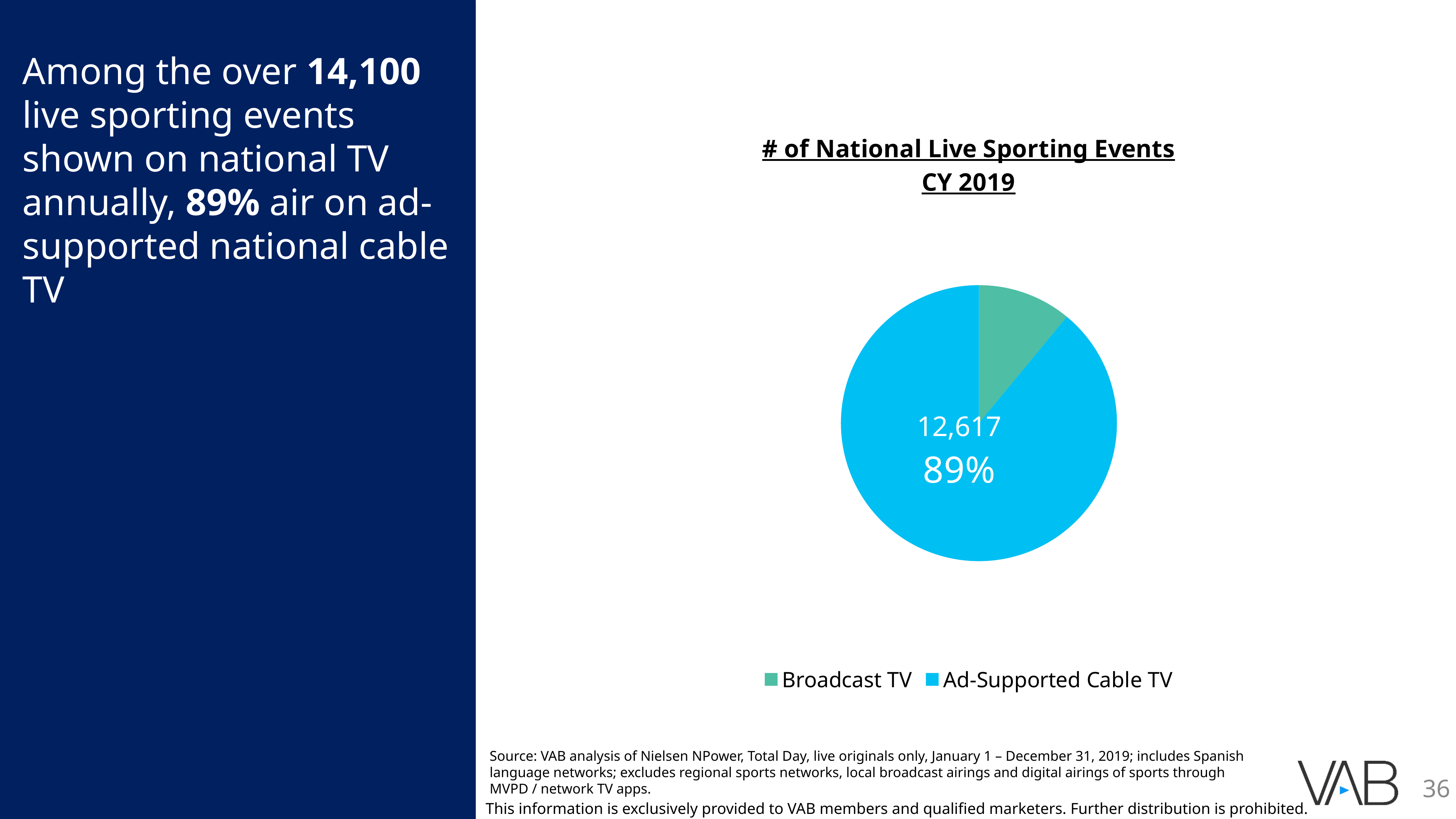
Which is larger, the Broadcast TV slice or the Ad-Supported Cable TV slice? Ad-Supported Cable TV What is the title of the chart? # of National Live Sporting Events CY 2019 Which category has the largest slice of the pie? Ad-Supported Cable TV How many national live sporting events aired on Ad-Supported Cable TV in CY 2019? 12,617 What colour is the Broadcast TV slice? green What kind of chart is shown on the slide? pie chart How many slices does the pie chart have? 2 Which category has the smallest slice of the pie? Broadcast TV What share of the pie does Ad-Supported Cable TV account for? 89% How many entries does the legend list? 2